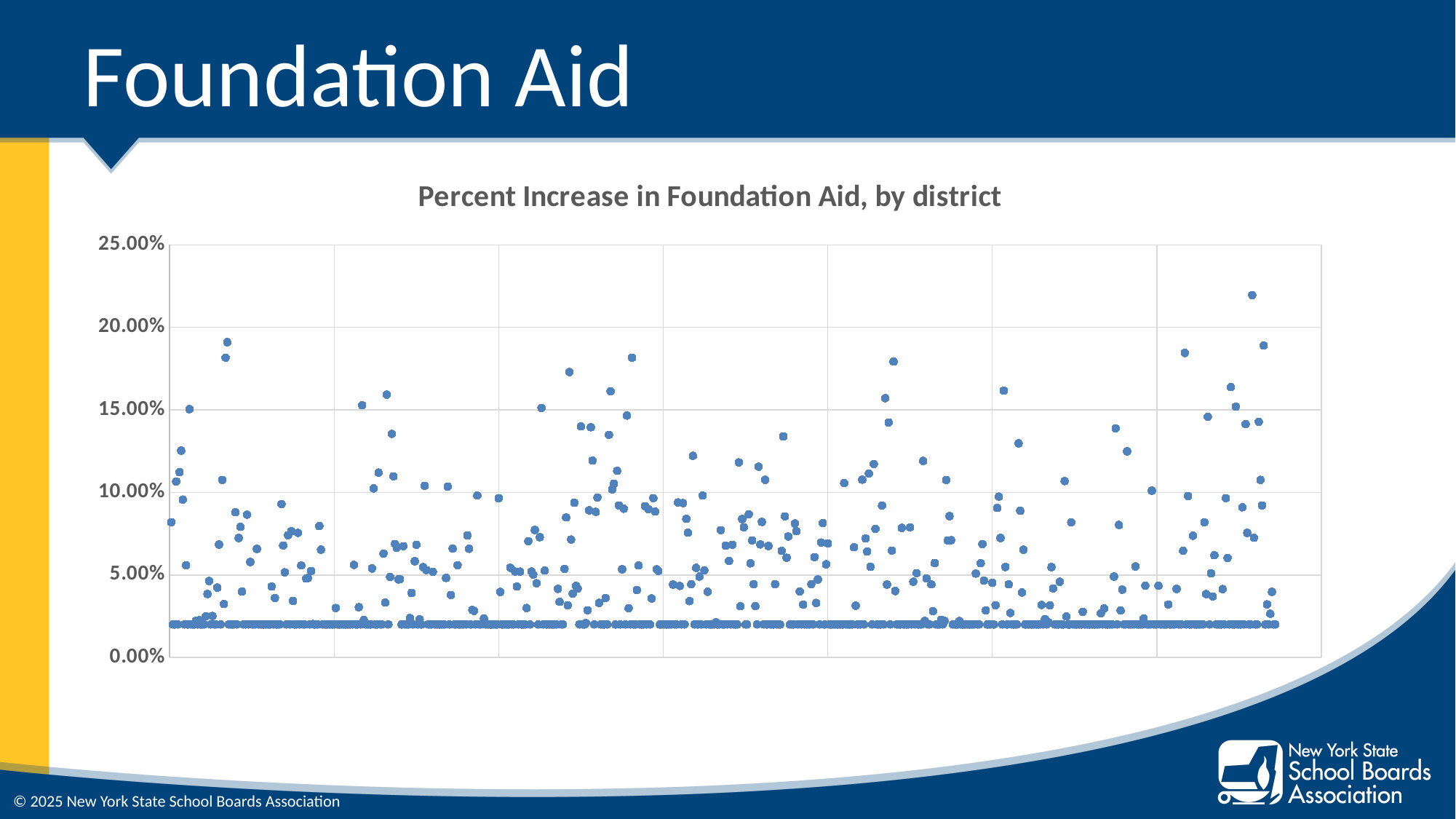
Is the highest point in the leftmost section of the chart (near the left edge) greater or less than 20%? less What is the highest value labelled on the vertical axis of the chart? 25.00% Is the dense band of points along the bottom of the chart greater or less than 5%? less Is the highest plotted point on the chart greater or less than 25%? less What kind of chart is shown on the slide? Scatter chart What is the title of the chart? Percent Increase in Foundation Aid, by district